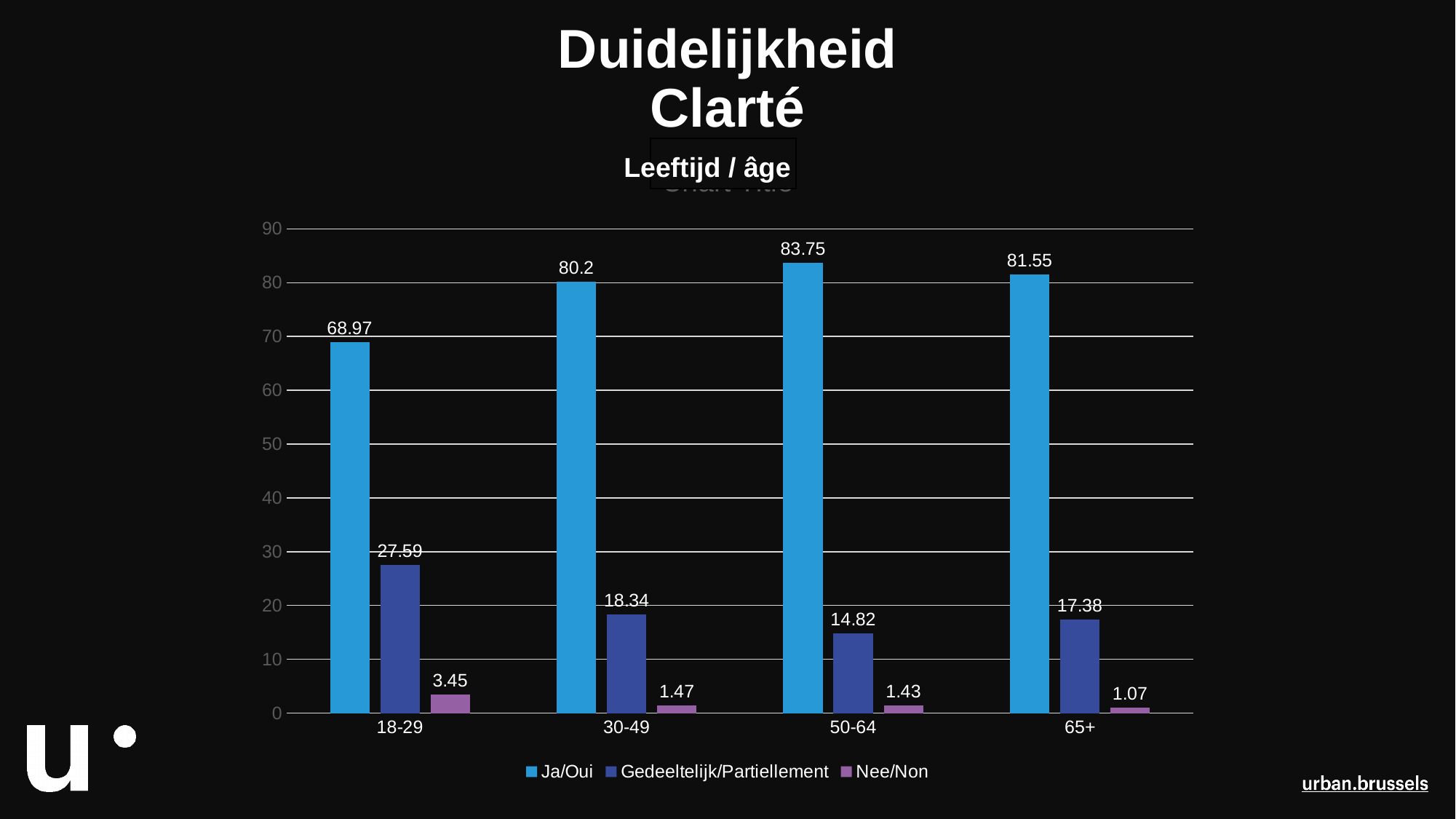
Which is larger: the Gedeeltelijk/Partiellement value for 30-49 or for 65+? 30-49 Which age group has the lowest Ja/Oui value? 18-29 Does the Nee/Non value rise or fall from the 18-29 group to the 65+ group? Fall How many series does the legend list? 3 What is the difference between the Ja/Oui values for 50-64 and 18-29? 14.78 What is the value for Gedeeltelijk/Partiellement in the 18-29 age group? 27.59 What is the value for Nee/Non in the 65+ age group? 1.07 What is the subtitle shown above the chart? Leeftijd / âge How many age groups are shown on the x axis? 4 What kind of chart is shown on the slide? Bar chart What is the value for Ja/Oui in the 50-64 age group? 83.75 Which age group has the highest Ja/Oui value? 50-64